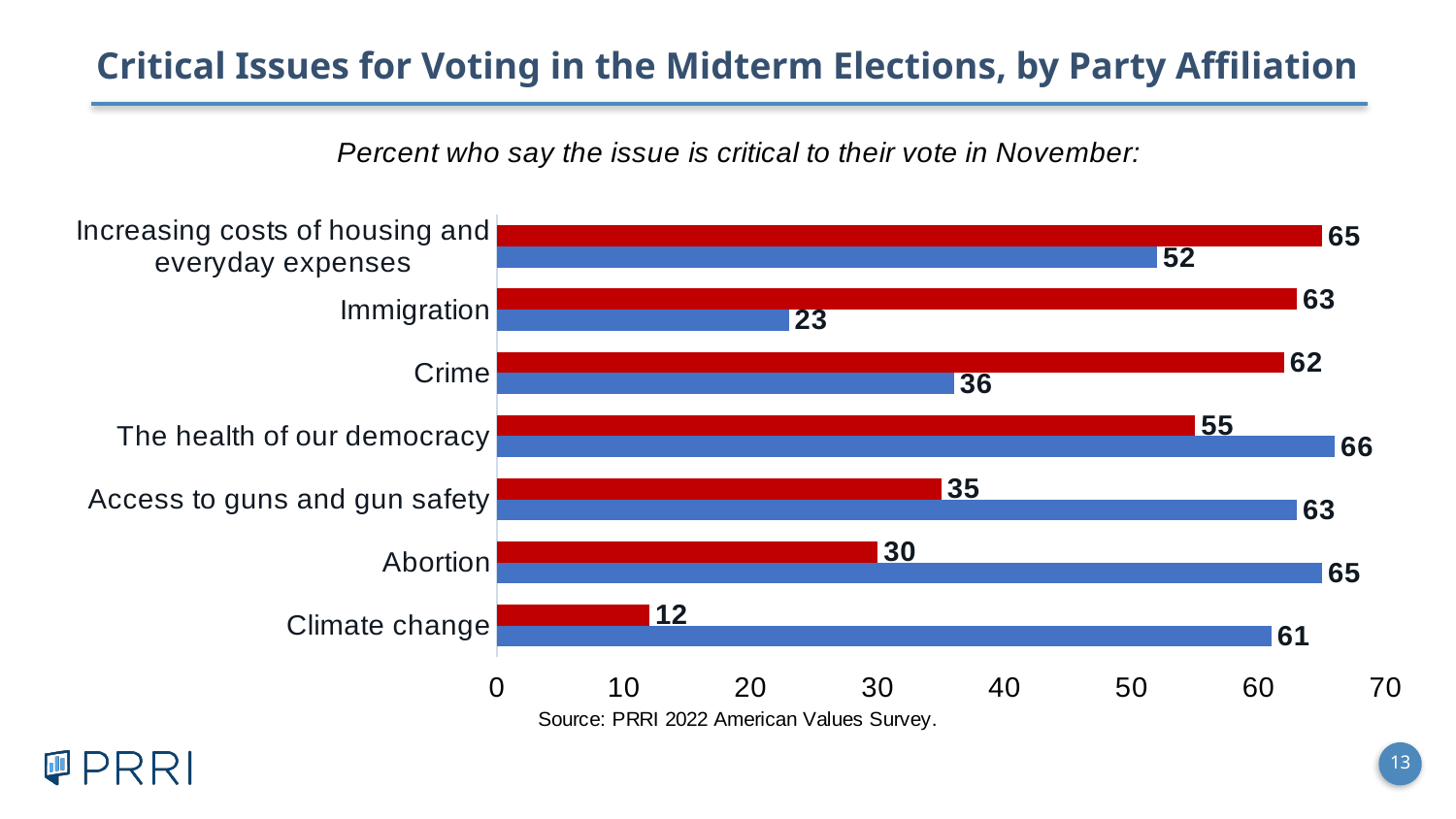
What is the difference between the red and blue bars for Immigration? 40 For The health of our democracy, which bar is larger, red or blue? blue What is the title of the chart on the slide? Percent who say the issue is critical to their vote in November: Which issue has the lowest value among the blue bars? Immigration How many issues are listed on the chart? 7 What is the value of the blue bar for Climate change? 61 Which issue has the lowest value among the red bars? Climate change What is the difference between the blue and red bars for Climate change? 49 What is the value of the blue bar for Crime? 36 What is the value of the red bar for Immigration? 63 What kind of chart is shown on the slide? bar chart Which issue has the highest value among the red bars? Increasing costs of housing and everyday expenses